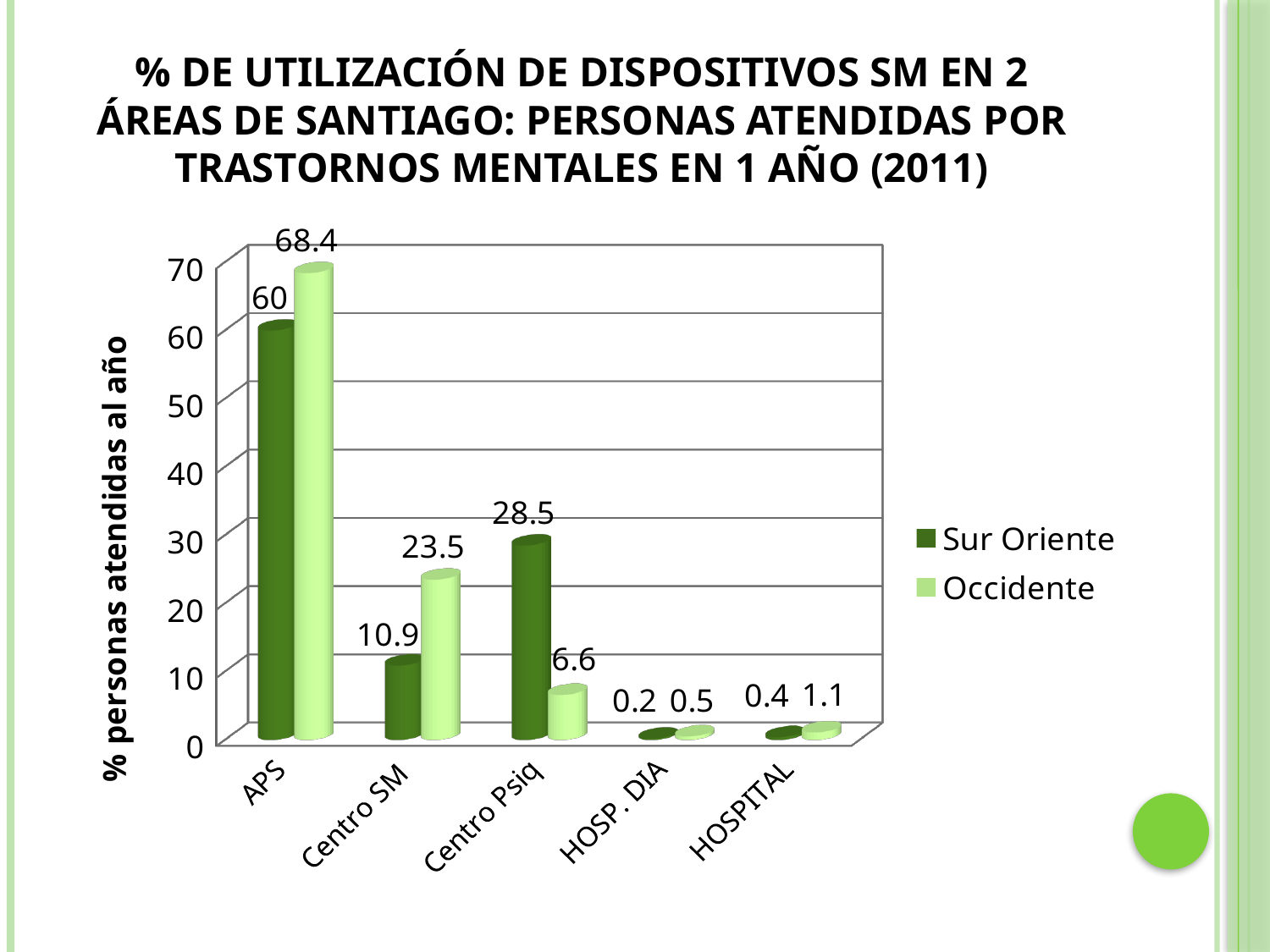
How many series does the legend list? 2 Which category has the lowest value for Sur Oriente? HOSP. DIA How many categories are shown on the x axis? 5 Which category has the highest value for Occidente? APS What is the value for Sur Oriente at APS? 60 What is the value for Sur Oriente at Centro Psiq? 28.5 What is the label of the vertical axis? % personas atendidas al año What is the value for Occidente at HOSP. DIA? 0.5 What kind of chart is shown on the slide? Bar chart Which is larger at Centro Psiq, Sur Oriente or Occidente? Sur Oriente What is the difference between the Occidente and Sur Oriente values at APS? 8.4 What is the value for Occidente at Centro SM? 23.5